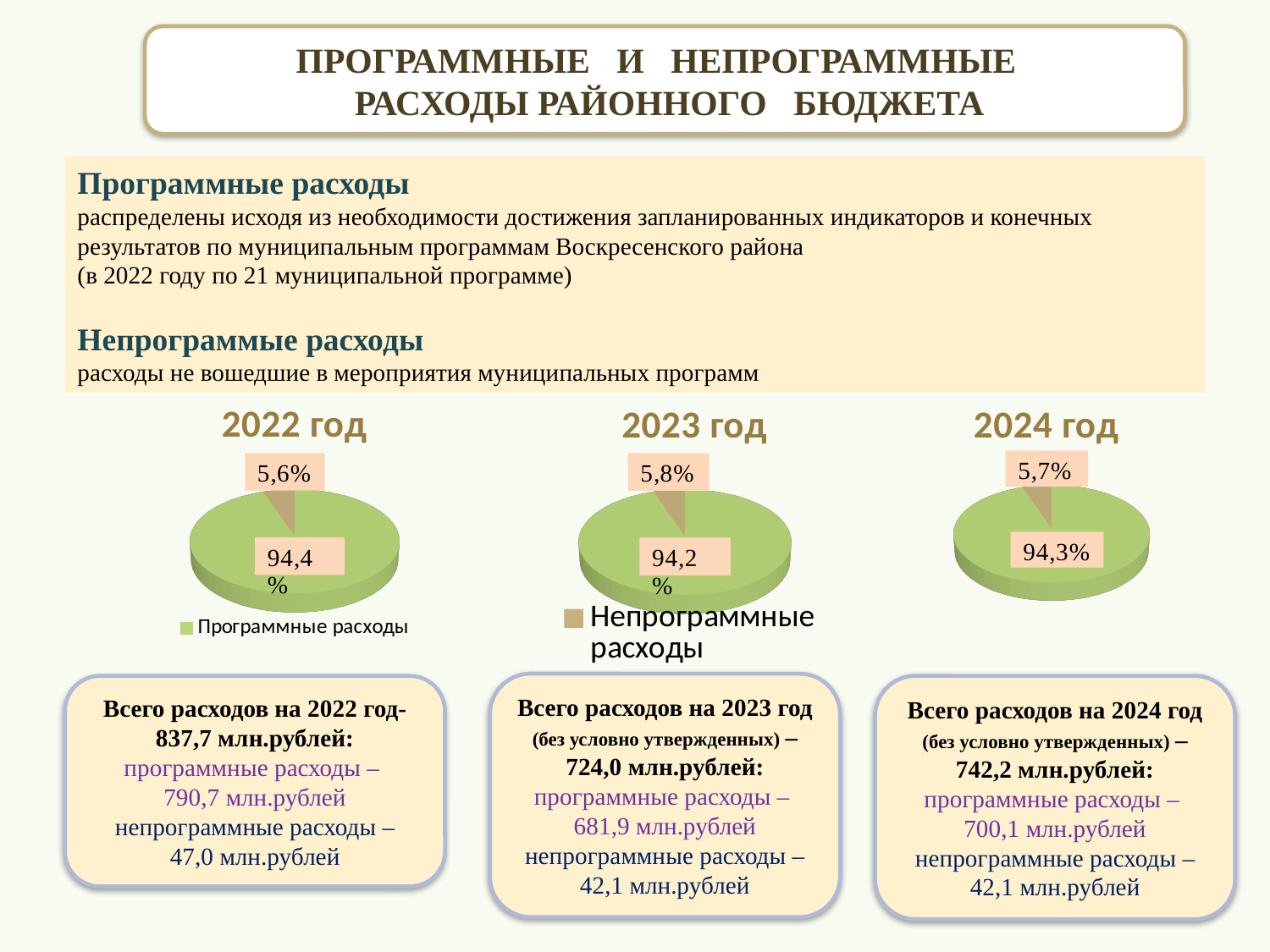
In the 2022 год chart, which slice is larger: Программные расходы or Непрограммные расходы? Программные расходы Which colour represents Программные расходы in the pie charts? green In the 2024 год chart, what share is shown for the smaller slice (Непрограммные расходы)? 5,7% How many slices does the 2024 год pie chart have? 2 In the 2022 год chart, what share is shown for the larger slice (Программные расходы)? 94,4% In the 2023 год chart, what is the difference between the two slices' percentages? 88,4% What kind of chart is used for the 2022 год chart? pie chart How many pie charts are shown on the slide? 3 In the 2023 год chart, what share is shown for the larger slice (Программные расходы)? 94,2% In the 2022 год chart, what share is shown for the smaller slice (Непрограммные расходы)? 5,6% In the 2023 год chart, what share is shown for the smaller slice (Непрограммные расходы)? 5,8% In the 2024 год chart, what share is shown for the larger slice (Программные расходы)? 94,3%